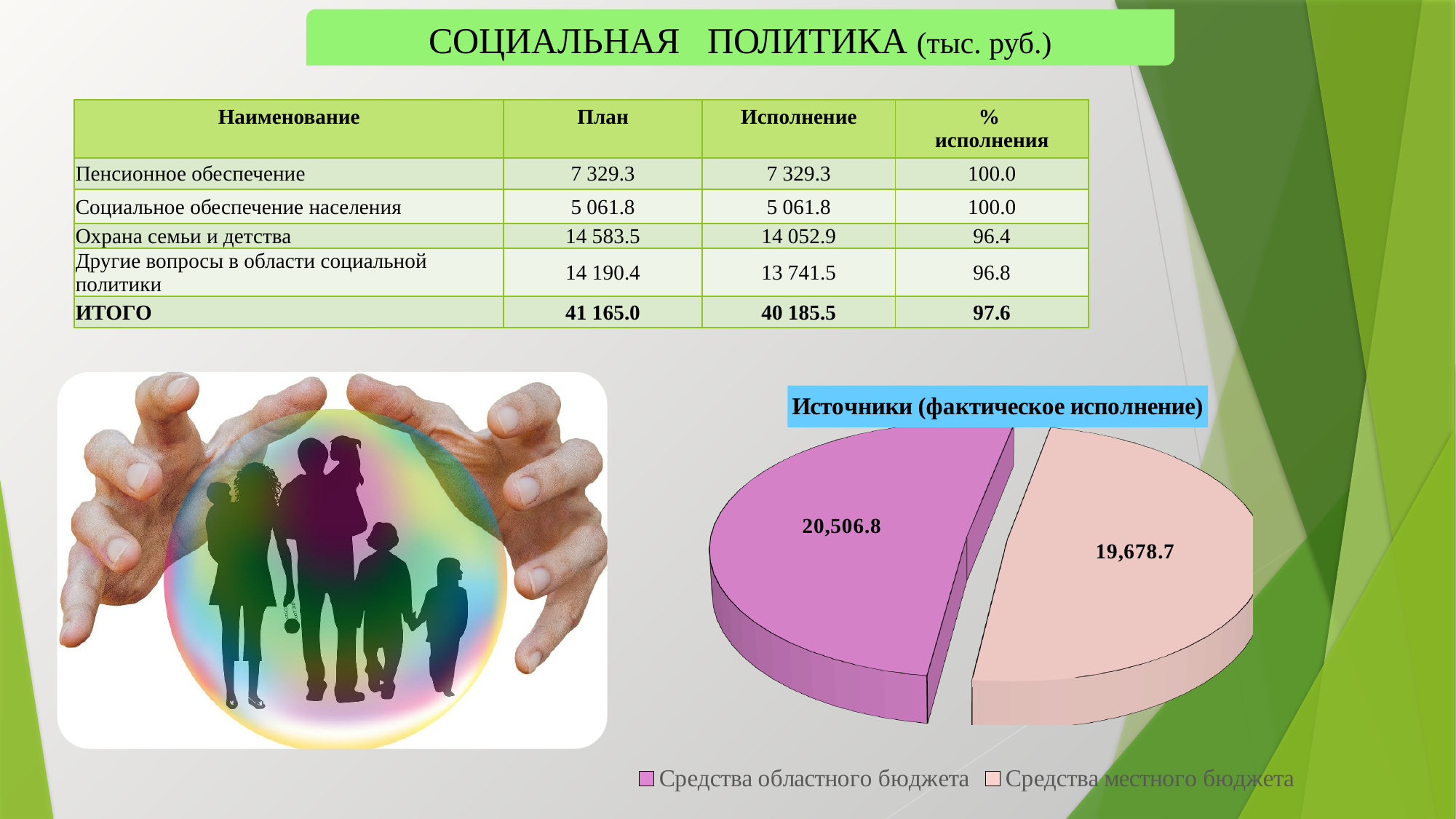
In the pie chart "Источники (фактическое исполнение)", what is the value for Средства областного бюджета? 20,506.8 How many entries does the legend of the pie chart "Источники (фактическое исполнение)" list? 2 In the pie chart "Источники (фактическое исполнение)", which source has the smaller value? Средства местного бюджета What kind of chart is shown under the title "Источники (фактическое исполнение)"? pie chart In the pie chart "Источники (фактическое исполнение)", which source has the larger value? Средства областного бюджета How many slices does the pie chart "Источники (фактическое исполнение)" have? 2 In the pie chart "Источники (фактическое исполнение)", what share of the total does Средства областного бюджета represent, to one decimal place? 51.0% In the pie chart "Источники (фактическое исполнение)", what is the value for Средства местного бюджета? 19,678.7 In the pie chart "Источники (фактическое исполнение)", what is the difference between the value for Средства областного бюджета and the value for Средства местного бюджета? 828.1 In the pie chart "Источники (фактическое исполнение)", what is the total of the two slices? 40,185.5 In the pie chart "Источники (фактическое исполнение)", which legend entry is shown in the purple/magenta colour? Средства областного бюджета In the pie chart "Источники (фактическое исполнение)", is the value for Средства областного бюджета larger or smaller than the value for Средства местного бюджета? larger